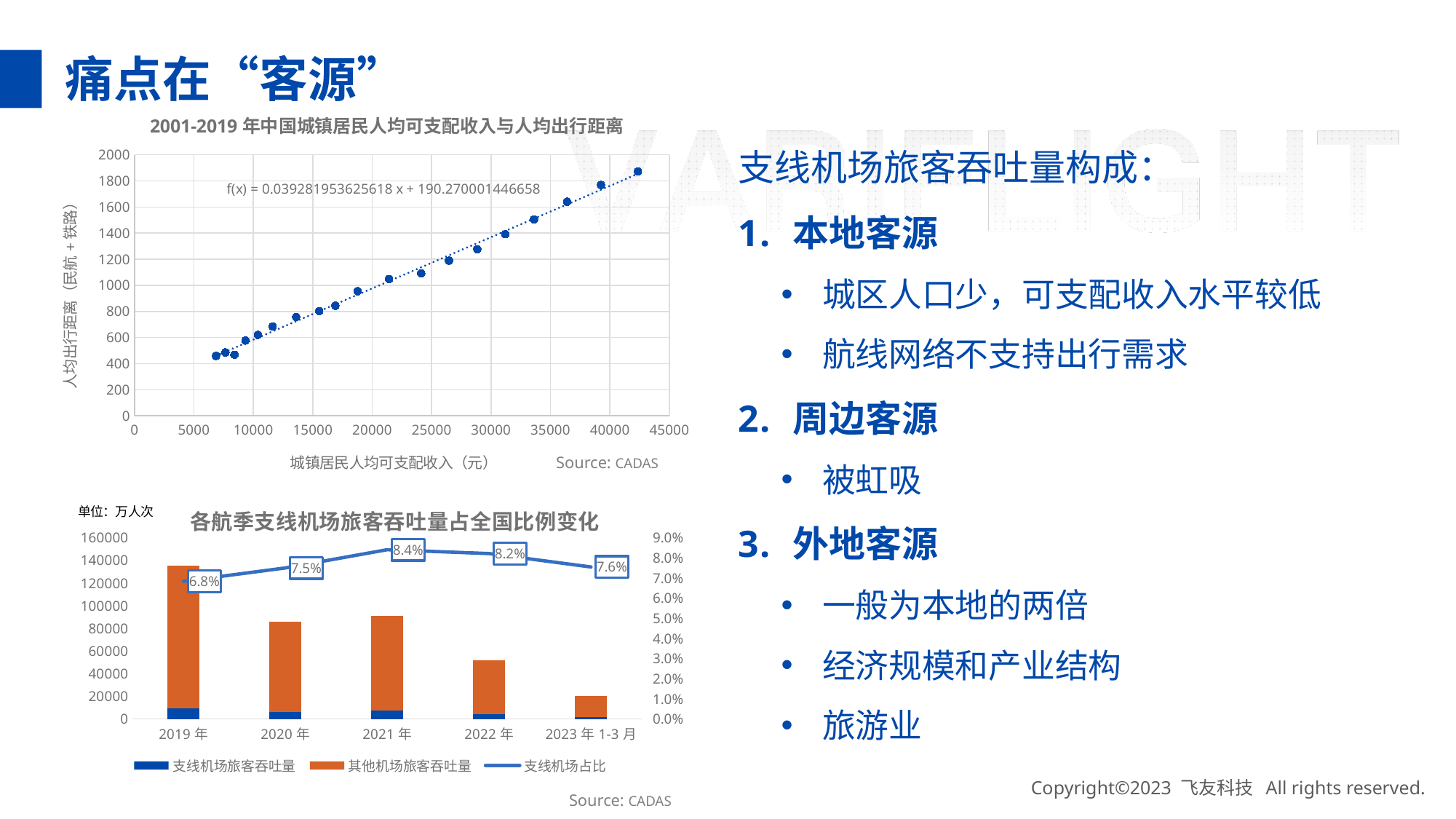
In the bottom chart (各航季支线机场旅客吞吐量占全国比例变化), what is the 支线机场占比 value for 2021 年? 8.4% In the bottom chart, what is the difference between the 支线机场占比 for 2021 年 and 2019 年? 1.6% What kind of chart is the top chart (2001-2019 年中国城镇居民人均可支配收入与人均出行距离)? scatter chart How many series does the legend of the bottom chart list? 3 In the bottom chart, is the total height of the stacked bar for 2023 年 1-3 月 greater or less than 40000? less In the top chart, does 人均出行距离 rise or fall as 城镇居民人均可支配收入 increases? rise In the bottom chart, what is the 支线机场占比 value for 2019 年? 6.8% In the bottom chart, which period has the highest 支线机场占比? 2021 年 In the bottom chart, is the total height of the stacked bar for 2019 年 greater or less than 120000? greater In the bottom chart, which has a higher 支线机场占比: 2022 年 or 2023 年 1-3 月? 2022 年 In the bottom chart, which period has the lowest 支线机场占比? 2019 年 How many periods are shown on the x axis of the bottom chart? 5